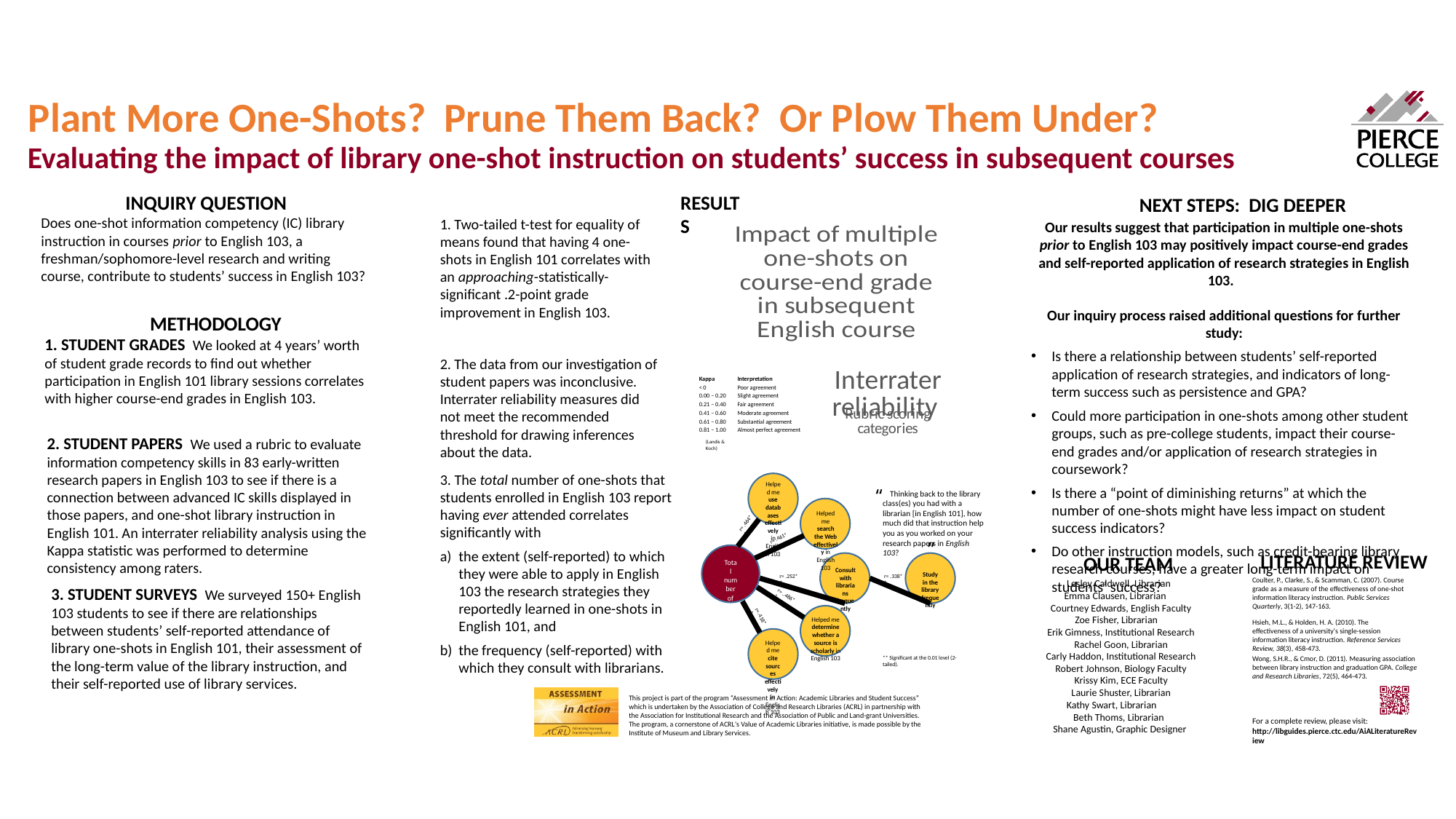
In the network diagram at the bottom of the RESULTS section, which has the larger printed correlation value: 'Consult with librarians' or 'Study in the library frequently'? Study in the library frequently In the network diagram at the bottom of the RESULTS section, what correlation value is printed on the link to 'Study in the library frequently'? r= .338* In the network diagram at the bottom of the RESULTS section, what is the label of the central node? Total number of What is the title of the second chart in the RESULTS section, shown next to the Kappa interpretation table? Interrater reliability What is the title of the chart at the top of the RESULTS section? Impact of multiple one-shots on course-end grade in subsequent English course In the network diagram at the bottom of the RESULTS section, what correlation value is printed on the link to 'Consult with librarians'? r= .252*